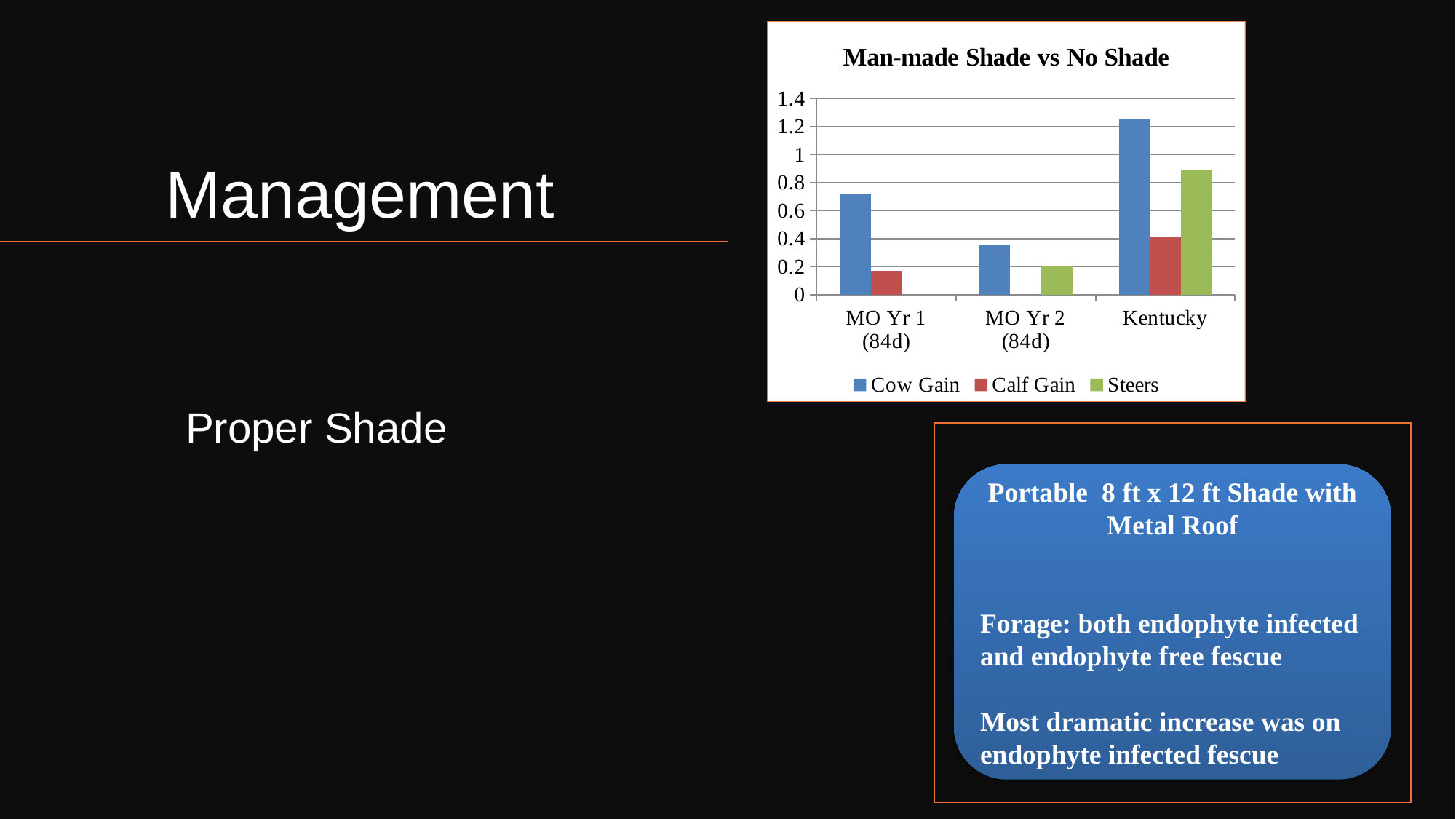
Which category has the lowest Cow Gain value? MO Yr 2 (84d) How many categories are shown on the x axis of the chart? 3 Is the Steers value for Kentucky greater or less than 0.8? greater Is the Cow Gain value for MO Yr 2 (84d) greater or less than 0.4? less Is the Cow Gain value for Kentucky greater or less than 1? greater How many series does the chart legend list? 3 What kind of chart is shown on the slide? bar chart Which category has the highest Cow Gain value? Kentucky What is the title of the chart? Man-made Shade vs No Shade For Kentucky, which is larger: Cow Gain or Steers? Cow Gain Which colour represents the Steers series in the chart? green